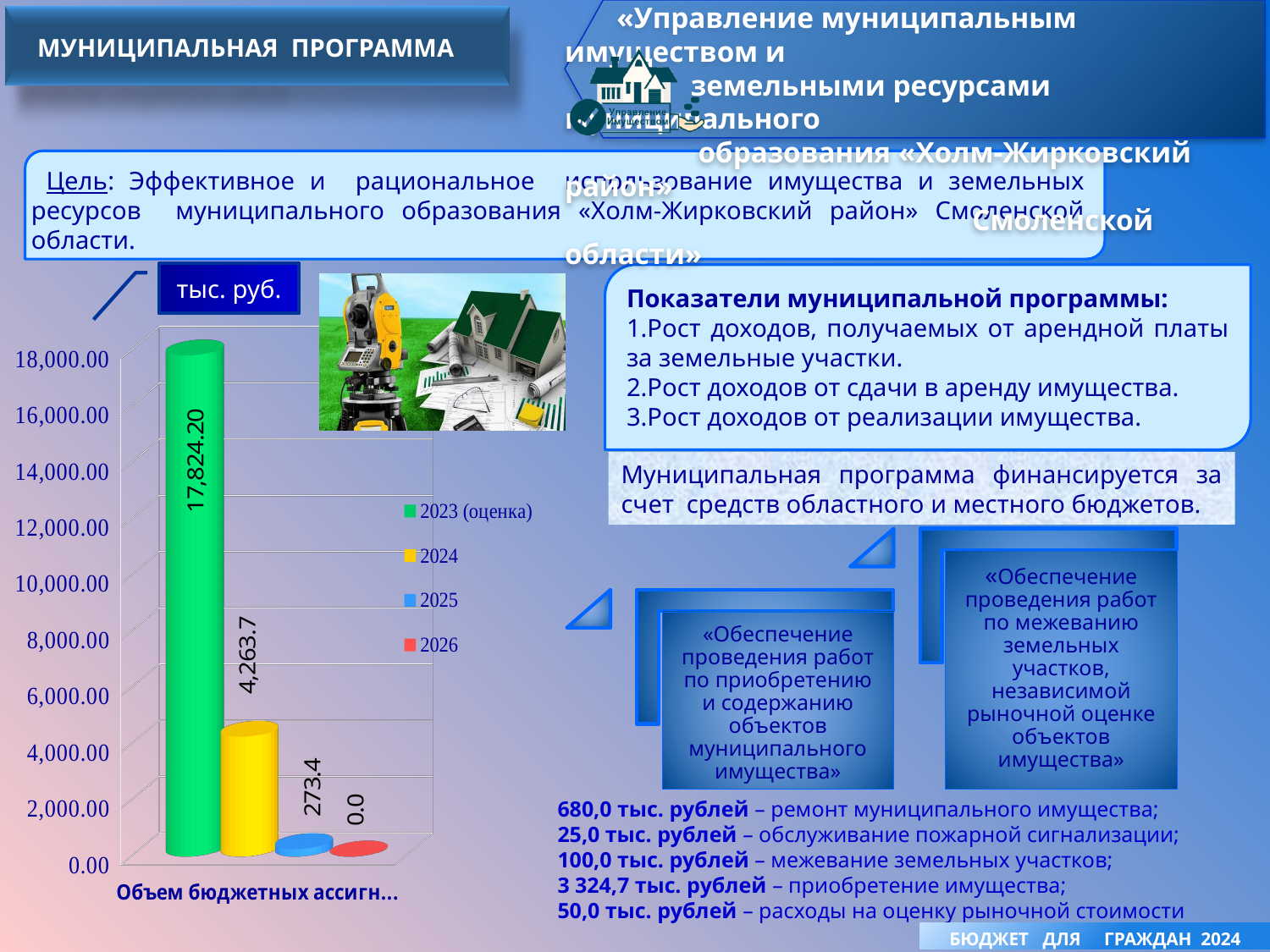
What unit is indicated for the values in the bar chart? тыс. руб. Which series has the highest value in the bar chart? 2023 (оценка) Is the value for 2023 (оценка) in the bar chart greater or less than 16,000.00? greater Which series has the lowest value in the bar chart? 2026 What kind of chart is shown on the slide? bar chart Which is larger in the bar chart, the value for 2024 or the value for 2025? 2024 What is the value shown for the 2024 series in the bar chart? 4,263.7 What is the difference between the 2024 value and the 2025 value in the bar chart? 3,990.3 How many series does the legend of the bar chart list? 4 What is the value shown for the 2023 (оценка) series in the bar chart? 17,824.20 What is the value shown for the 2026 series in the bar chart? 0.0 What is the value shown for the 2025 series in the bar chart? 273.4